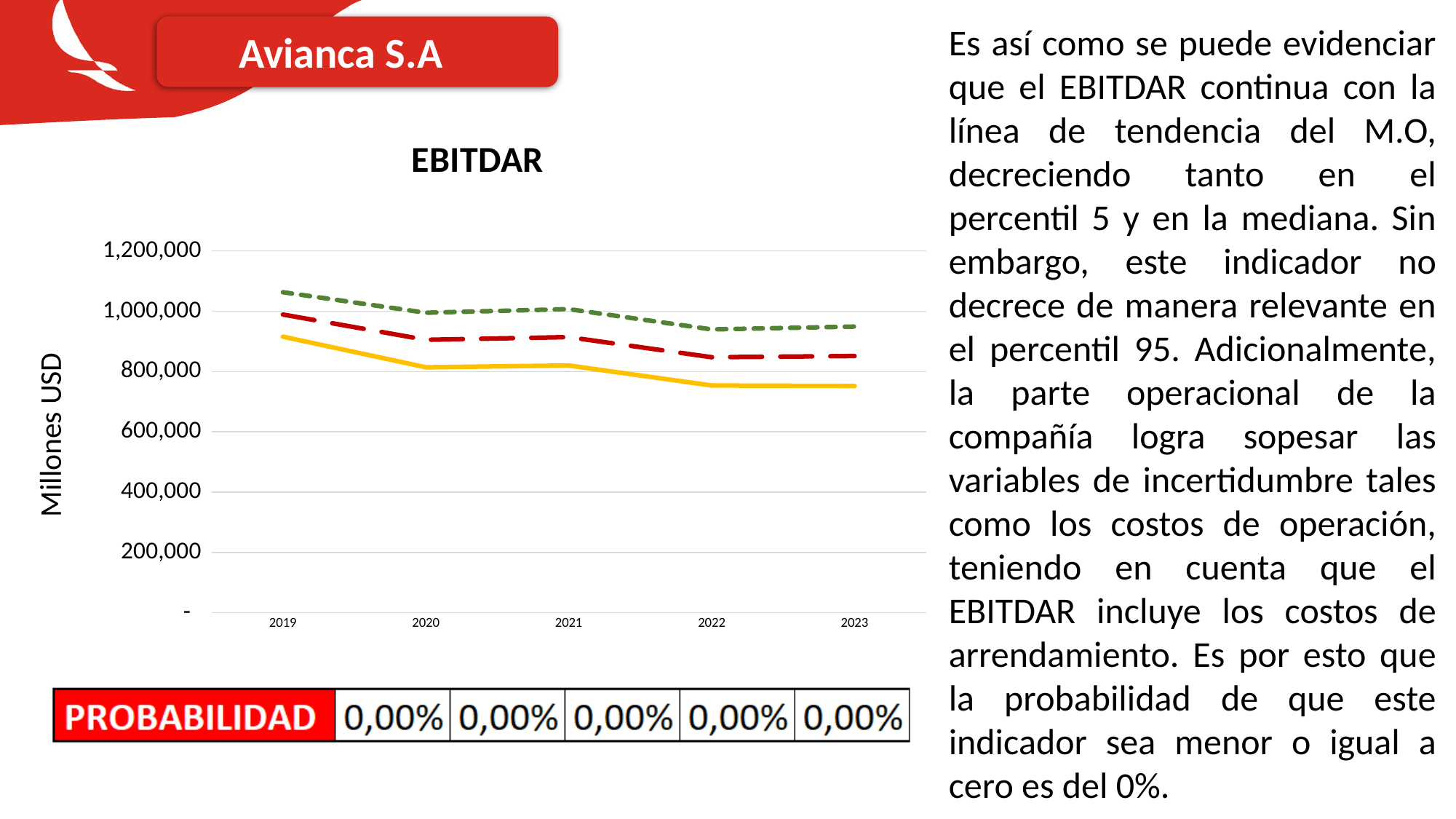
How many lines are plotted in the EBITDAR chart? 3 What kind of chart is shown under the title EBITDAR? line chart Do the values of the green dotted line in the EBITDAR chart generally rise or fall from 2019 to 2023? fall In the EBITDAR chart, is the value of the green dotted line in 2023 greater or less than 1,000,000? less In the EBITDAR chart, is the value of the solid yellow line in 2023 greater or less than 800,000? less In the EBITDAR chart, is the value of the green dotted line in 2019 greater or less than 1,000,000? greater How many years are shown on the x axis of the EBITDAR chart? 5 In the EBITDAR chart, which year has the highest value on the green dotted line? 2019 What is the label of the vertical axis of the EBITDAR chart? Millones USD Do the values of the solid yellow line in the EBITDAR chart generally rise or fall from 2019 to 2023? fall What is the title of the chart on the slide? EBITDAR